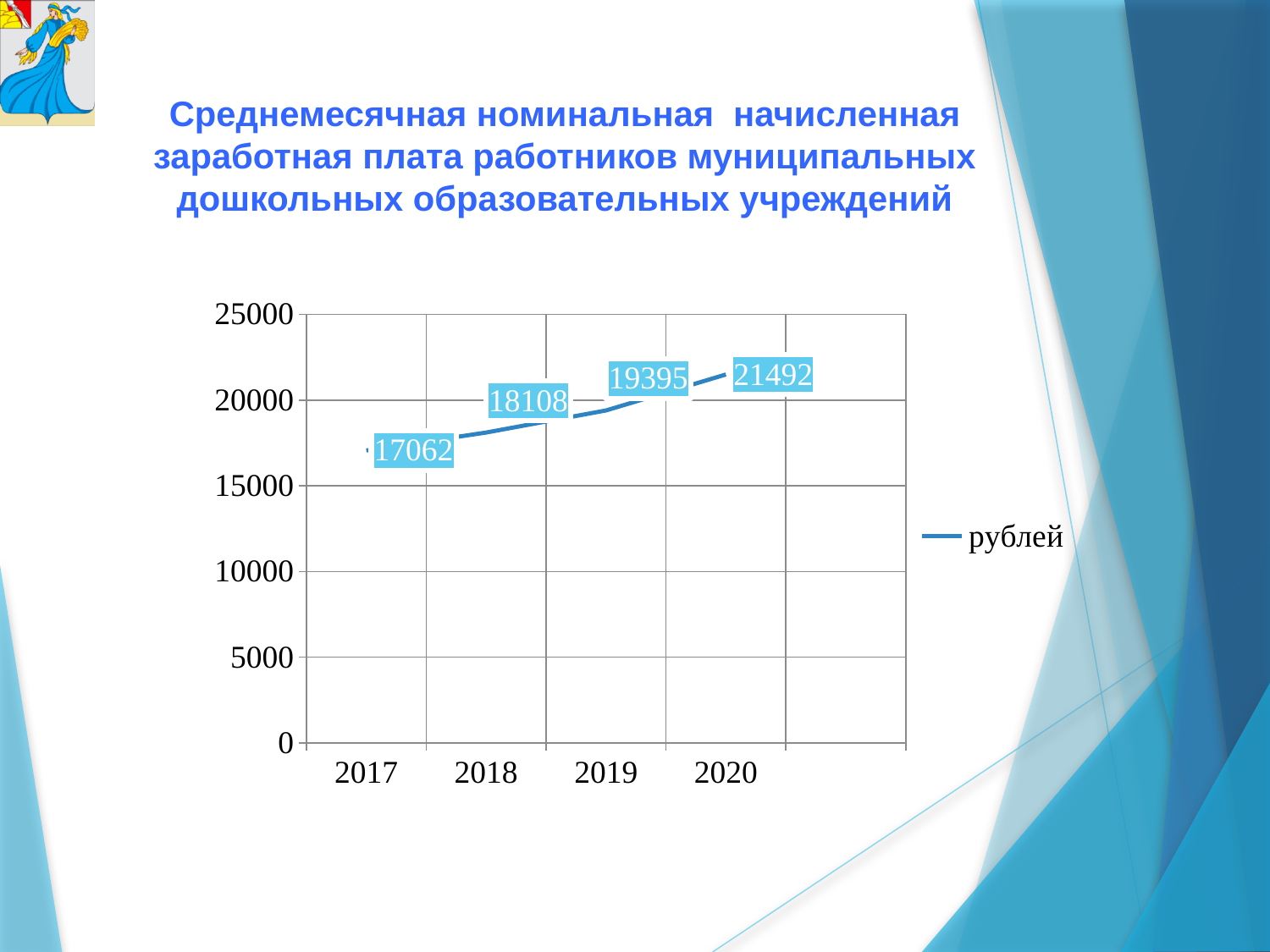
What is the value for 2020? 21492 Which is larger, the value for 2018 or the value for 2019? 2019 What is the difference between the values for 2019 and 2018? 1287 What is the value for 2019? 19395 Which year has the lowest value? 2017 Do the values rise or fall from 2017 to 2020? rise What is the value for 2018? 18108 Which year has the highest value? 2020 What is the value for 2017? 17062 What is the difference between the values for 2020 and 2017? 4430 What kind of chart is shown on the slide? line chart How many years are plotted on the chart? 4